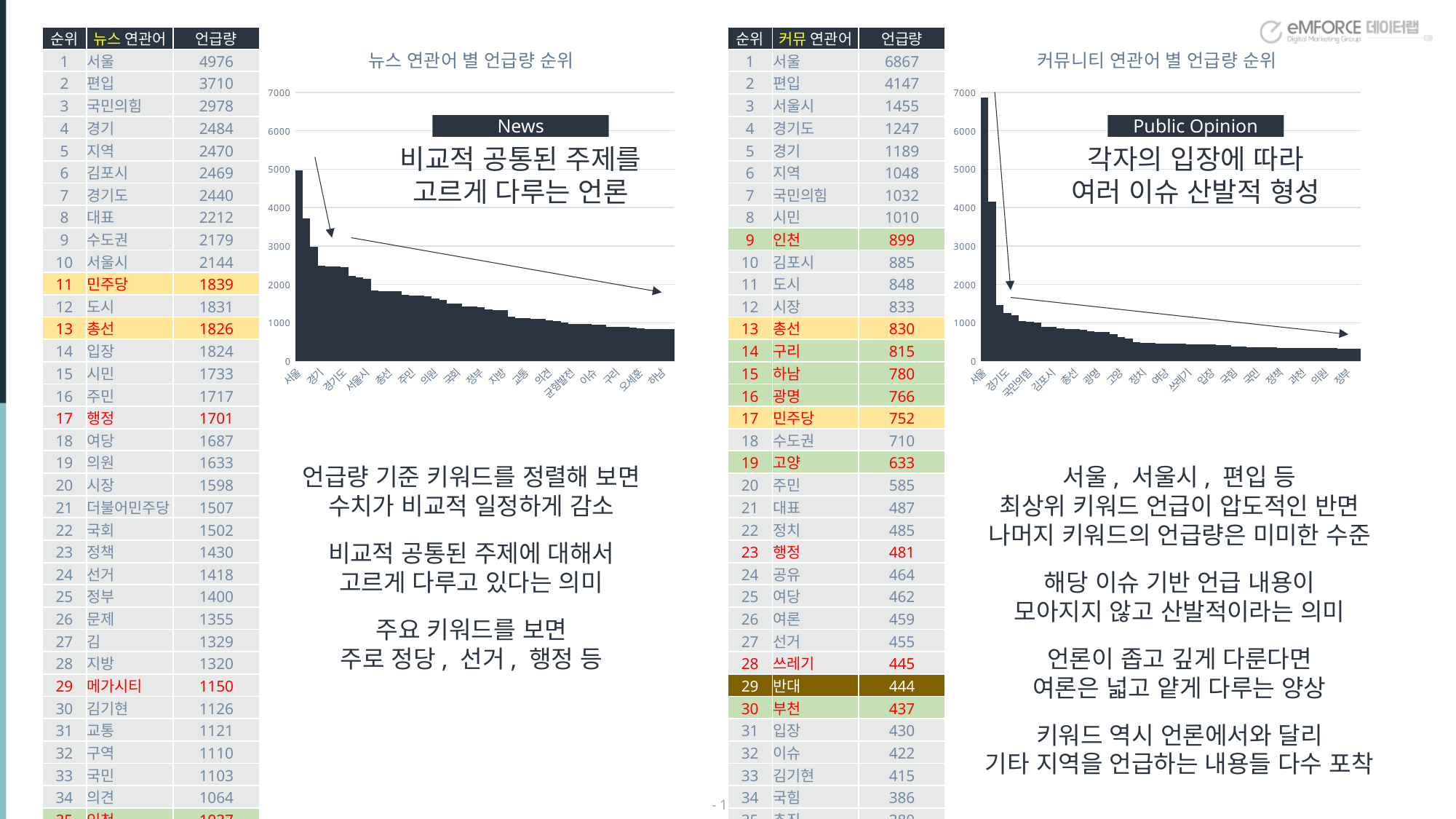
In the right chart (커뮤니티 연관어 별 언급량 순위), which category has the highest value? 서울 In the right chart (커뮤니티 연관어 별 언급량 순위), is the value for 서울 greater or less than 6000? greater In the left chart (뉴스 연관어 별 언급량 순위), is the value for 하남 greater or less than 1000? less In the left chart (뉴스 연관어 별 언급량 순위), do the values rise or fall from left to right along the x axis? fall What label appears in the dark box above the text inside the right chart (커뮤니티 연관어 별 언급량 순위)? Public Opinion In the right chart (커뮤니티 연관어 별 언급량 순위), is the value for 정부 greater or less than 1000? less In the right chart (커뮤니티 연관어 별 언급량 순위), which is larger, the value for 서울 or the value for 경기도? 서울 What kind of chart is the right chart titled 커뮤니티 연관어 별 언급량 순위? bar chart In the left chart (뉴스 연관어 별 언급량 순위), which category has the highest value? 서울 What kind of chart is the left chart titled 뉴스 연관어 별 언급량 순위? bar chart